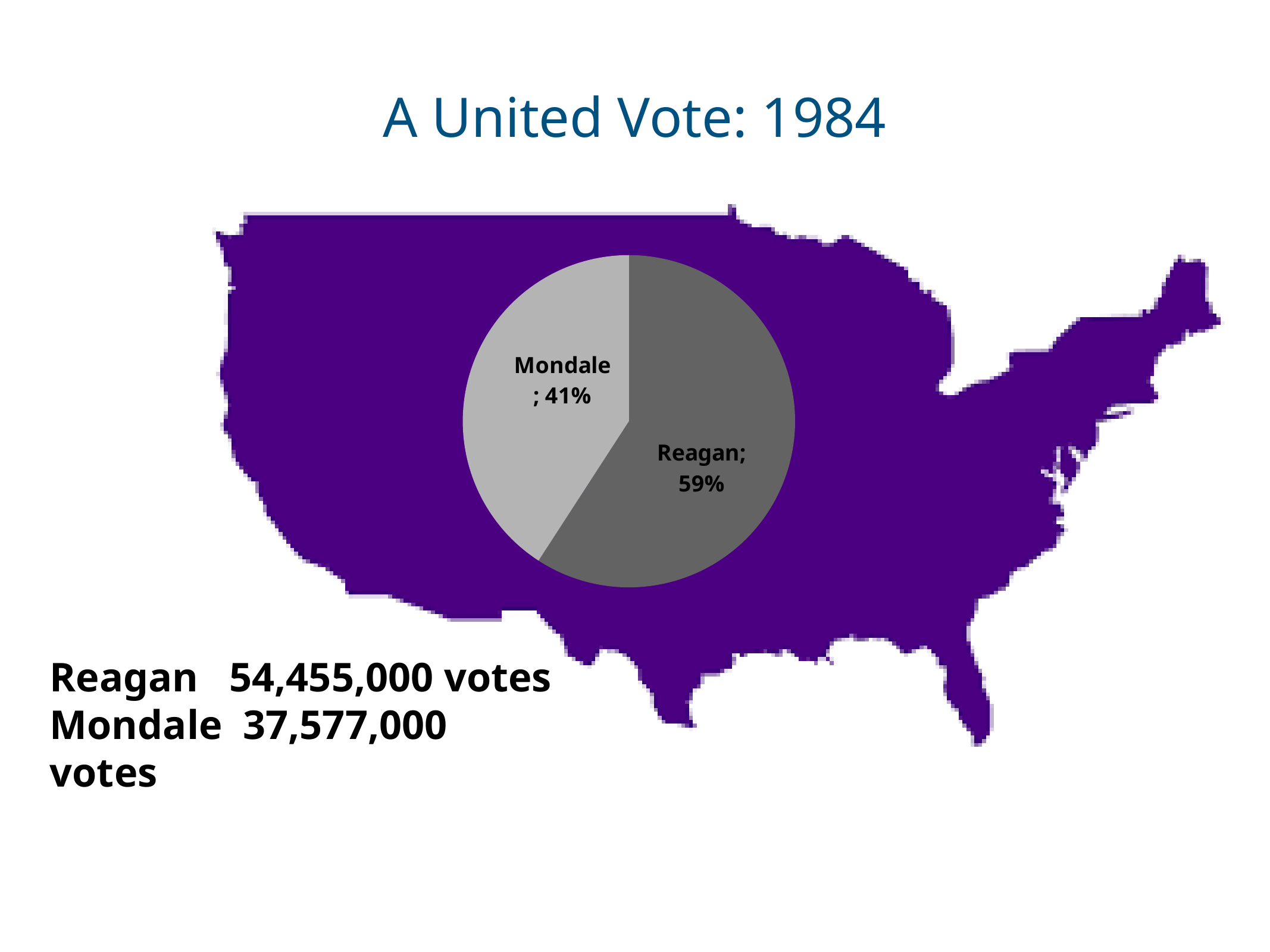
What is the difference in percentage points between Reagan's and Mondale's slices? 18 percentage points Which slice is larger, Reagan's or Mondale's? Reagan's Which slice of the pie is shaded in the darker grey? Reagan Which candidate has the largest slice of the pie? Reagan What kind of chart is shown on the slide? pie chart How many slices does the pie chart have? 2 Which candidate has the smallest slice of the pie? Mondale What share of the pie does Mondale's slice represent? 41% What share of the pie does Reagan's slice represent? 59% What is the title of the slide containing the pie chart? A United Vote: 1984